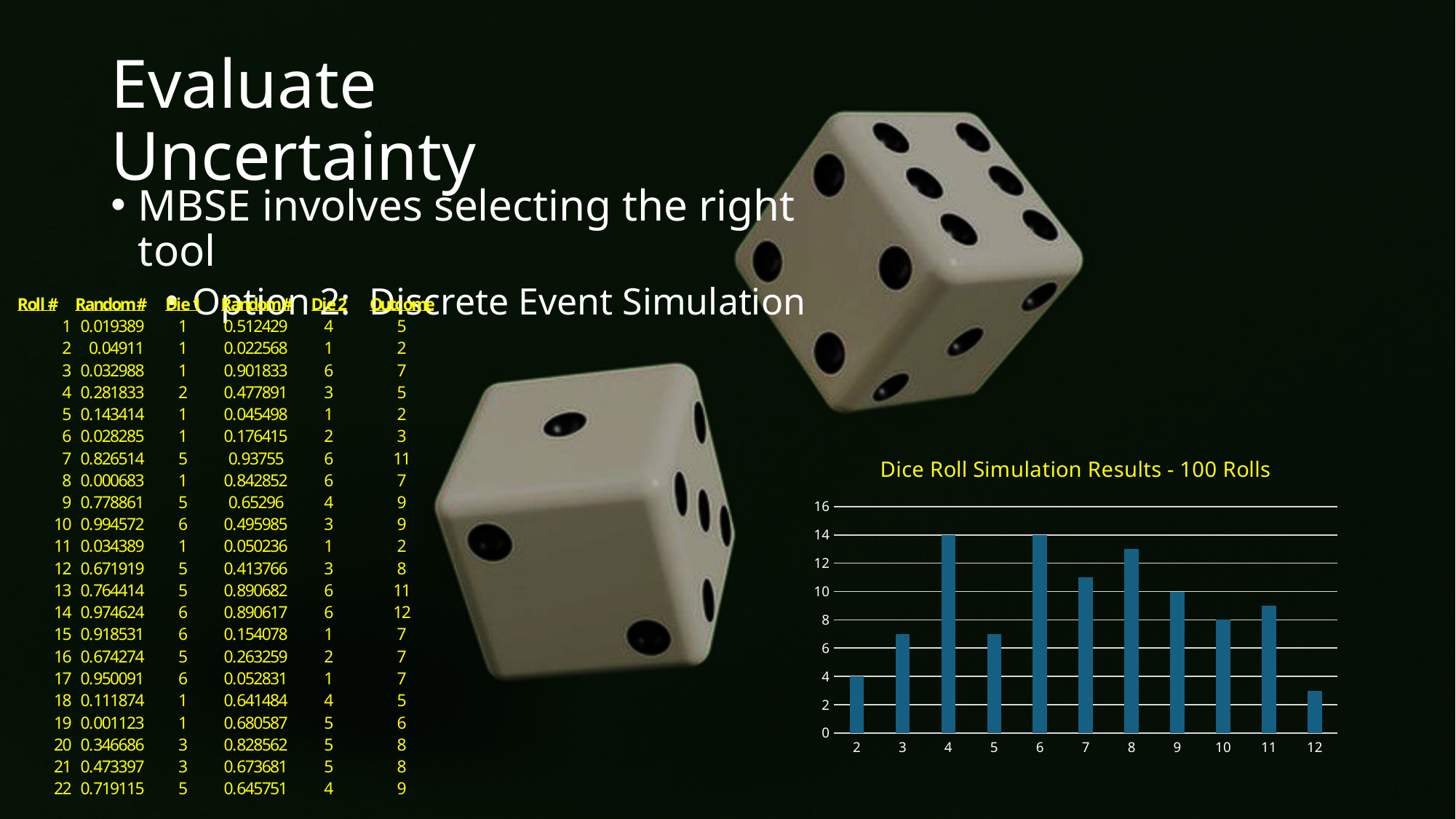
What is the value for outcome 9 in the chart? 10 Is the value for outcome 12 greater or less than 4? less How many outcome categories are shown on the x axis of the chart? 11 Which outcome has the lowest value in the chart? 12 What type of chart is shown on the slide? bar chart What is the title of the chart? Dice Roll Simulation Results - 100 Rolls What is the value for outcome 4 in the chart? 14 Which has a larger value, outcome 6 or outcome 11? outcome 6 Is the value for outcome 8 greater or less than 12? greater Is the value for outcome 7 greater or less than 10? greater What is the value for outcome 2 in the chart? 4 What is the value for outcome 10 in the chart? 8